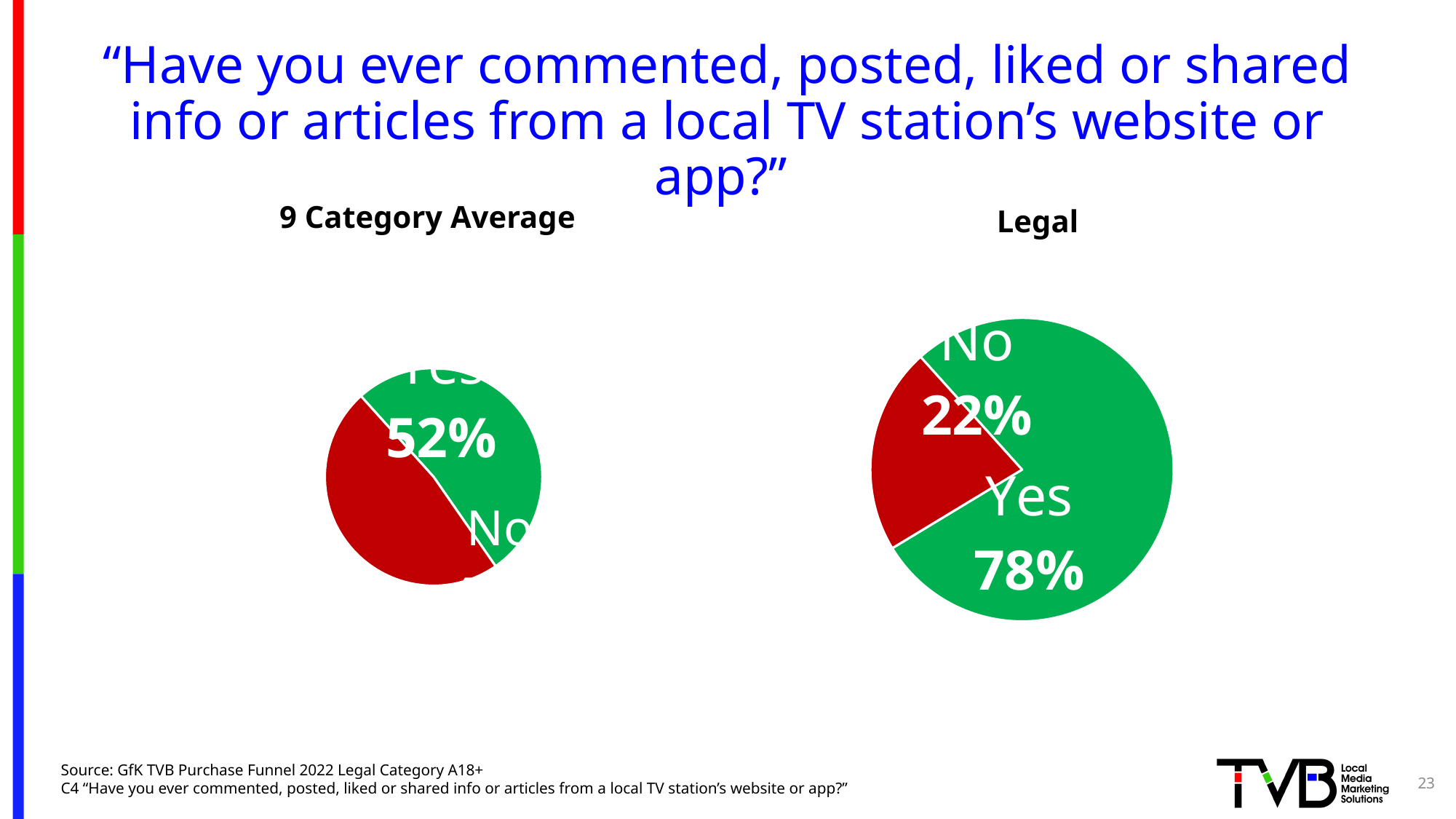
How many slices does the Legal pie chart have? 2 In the Legal pie chart, what is the difference in percentage points between Yes and No? 56 percentage points In the Legal pie chart, which response has the largest share? Yes In the Legal pie chart, what percentage answered No? 22% In the Legal pie chart, which response has the smallest share? No In the 9 Category Average pie chart, what percentage answered Yes? 52% In the Legal pie chart, what colour is the Yes slice? Green Which is larger: the Yes share in the Legal chart or the Yes share in the 9 Category Average chart? Legal What type of chart is used on this slide? Pie chart How many percentage points higher is the Yes share in the Legal chart than in the 9 Category Average chart? 26 percentage points How many pie charts are shown on the slide? 2 In the Legal pie chart, what percentage answered Yes? 78%